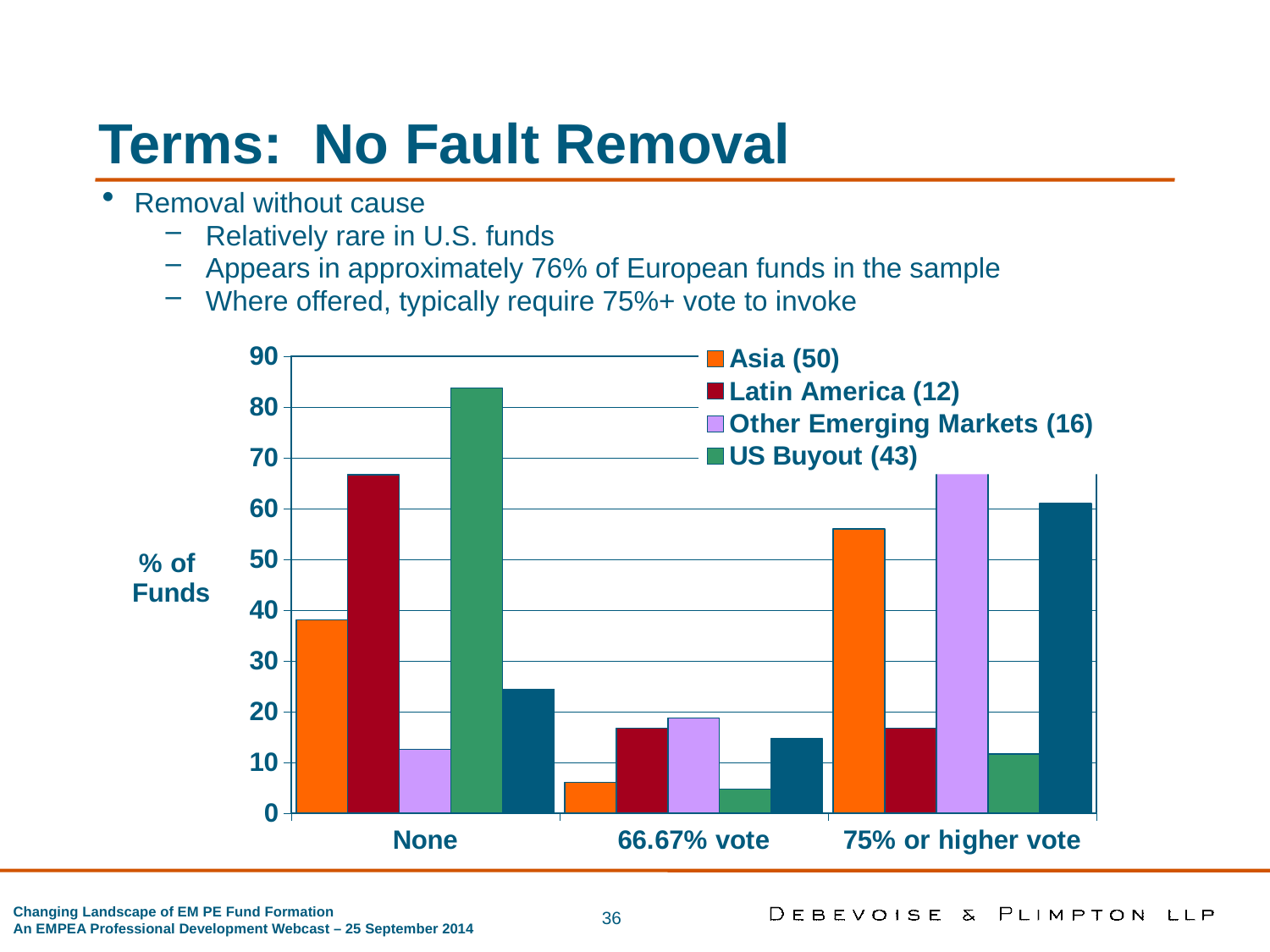
How many vote-threshold categories are shown on the x axis of the chart? 3 Is the value for US Buyout (43) in the "None" category greater or less than 80? greater What is the label on the vertical axis of the chart? % of Funds Is the value for Asia (50) in the "75% or higher vote" category greater or less than 50? greater In the "None" category, which legend series has the lowest bar? Other Emerging Markets (16) In the "None" category, which legend series has the highest bar? US Buyout (43) In the "75% or higher vote" category, which legend series has the highest bar? Other Emerging Markets (16) In the "None" category, which is larger: the bar for Asia (50) or the bar for Latin America (12)? Latin America (12) What kind of chart is shown on the slide? bar chart How many series does the chart's legend list? 4 In the "75% or higher vote" category, which legend series has the lowest bar? US Buyout (43) Is the value for Asia (50) in the "None" category greater or less than 50? less